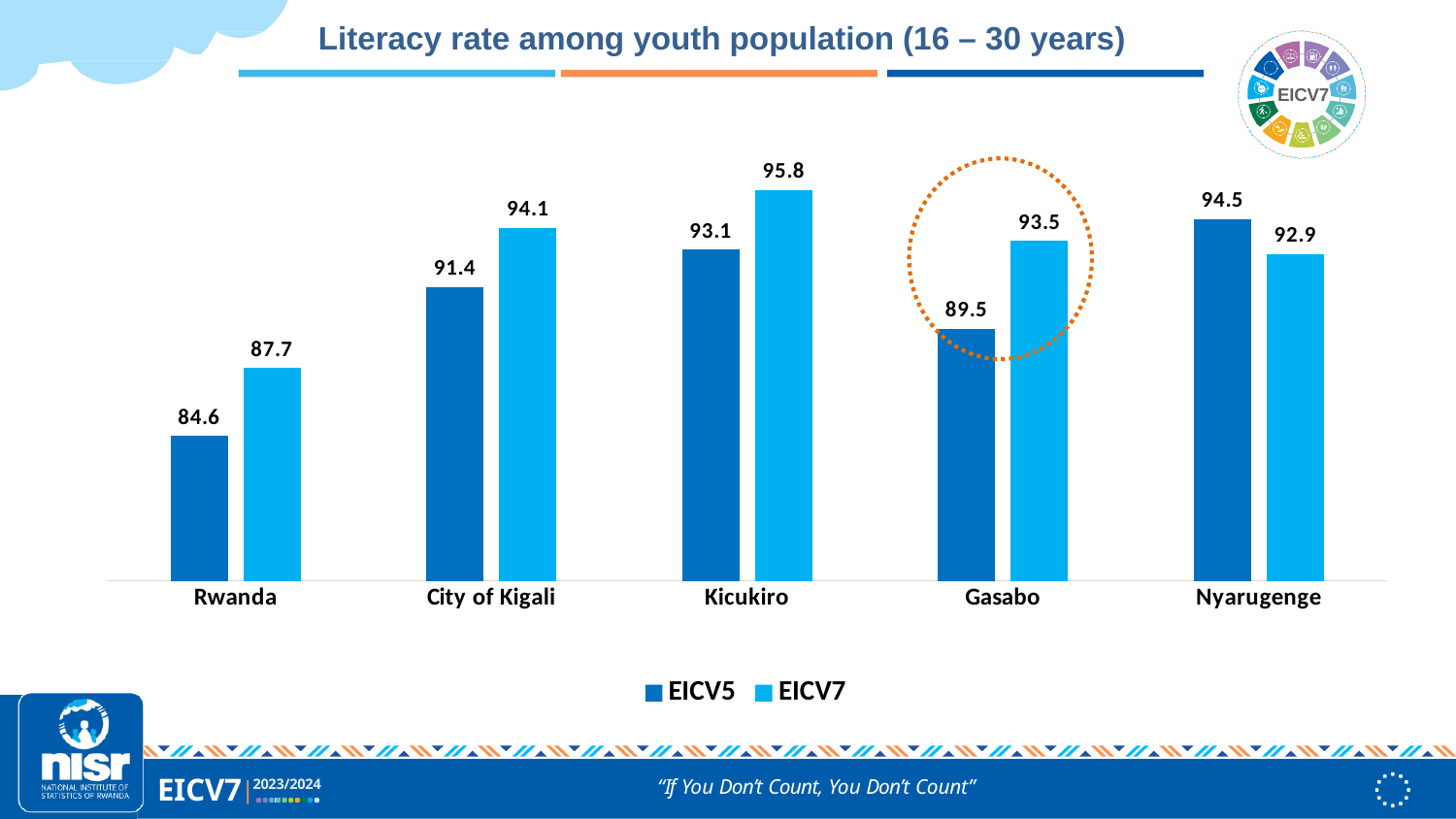
What is the EICV5 literacy rate for Gasabo? 89.5 What is the difference between the EICV7 and EICV5 values for Gasabo? 4.0 What is the EICV7 literacy rate for Kicukiro? 95.8 Which category has the lowest EICV5 value? Rwanda What is the title of the chart? Literacy rate among youth population (16 – 30 years) Which category has the highest EICV7 value? Kicukiro What is the EICV7 literacy rate for Rwanda? 87.7 For Nyarugenge, which is larger, the EICV5 value or the EICV7 value? EICV5 What kind of chart is shown on the slide? Bar chart How many categories are shown on the x axis? 5 How many series does the legend list? 2 What is the difference between the EICV7 and EICV5 values for Rwanda? 3.1